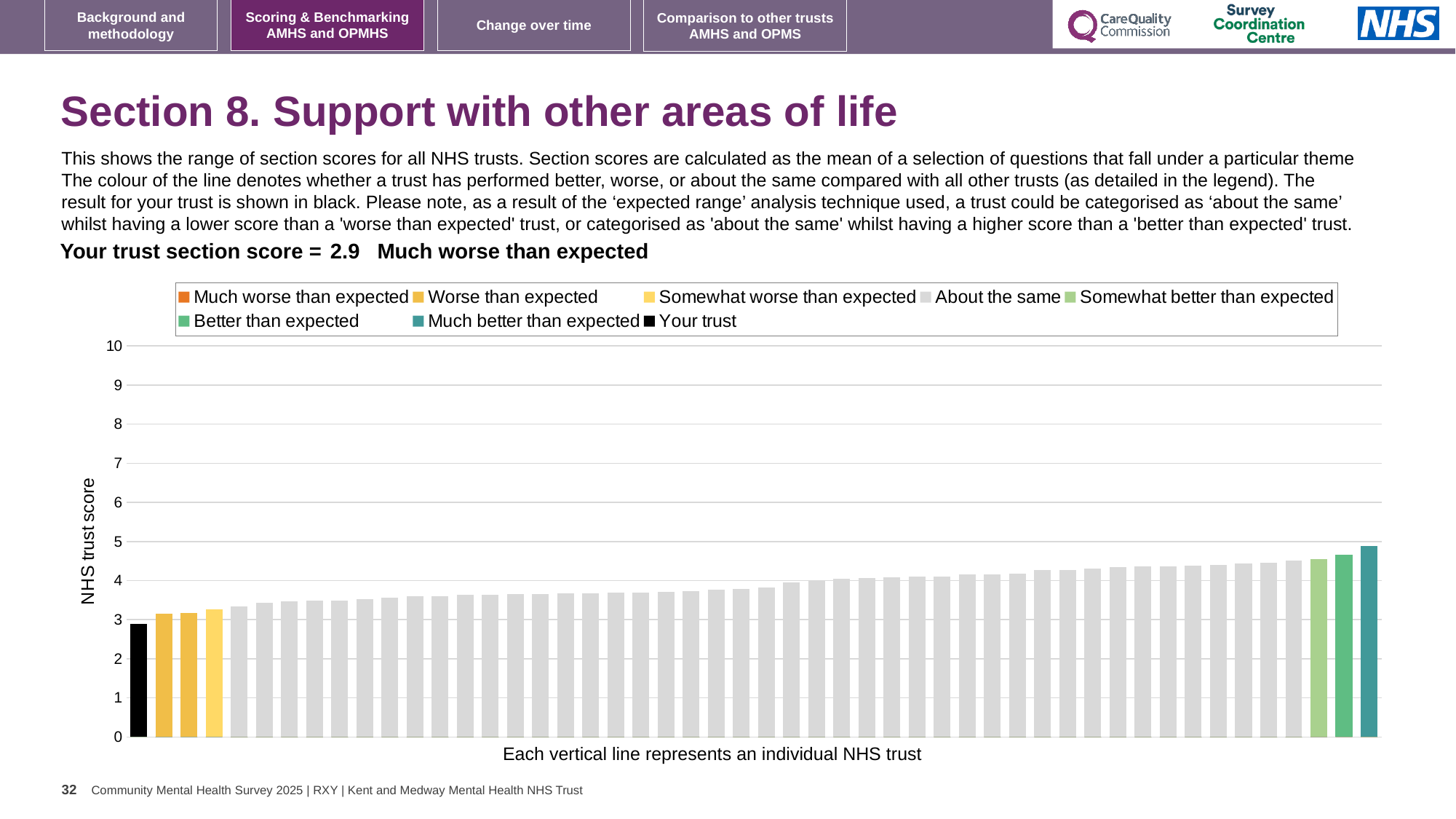
Which category is your trust's section score placed in? Much worse than expected What is the title of the vertical axis? NHS trust score Which is larger: the black 'Your trust' bar or the teal 'Much better than expected' bar? Much better than expected How many entries does the chart legend list? 8 What is the section score for your trust? 2.9 Is the value for your trust greater or less than 5? less What kind of chart is shown on the slide? Bar chart Is the value of the tallest bar (Much better than expected) greater or less than 4? greater Which bar in the chart is the lowest? Your trust Is the value for your trust greater or less than 3? less What colour is the bar representing your trust? Black Do the bar values rise or fall from left to right along the x axis? Rise